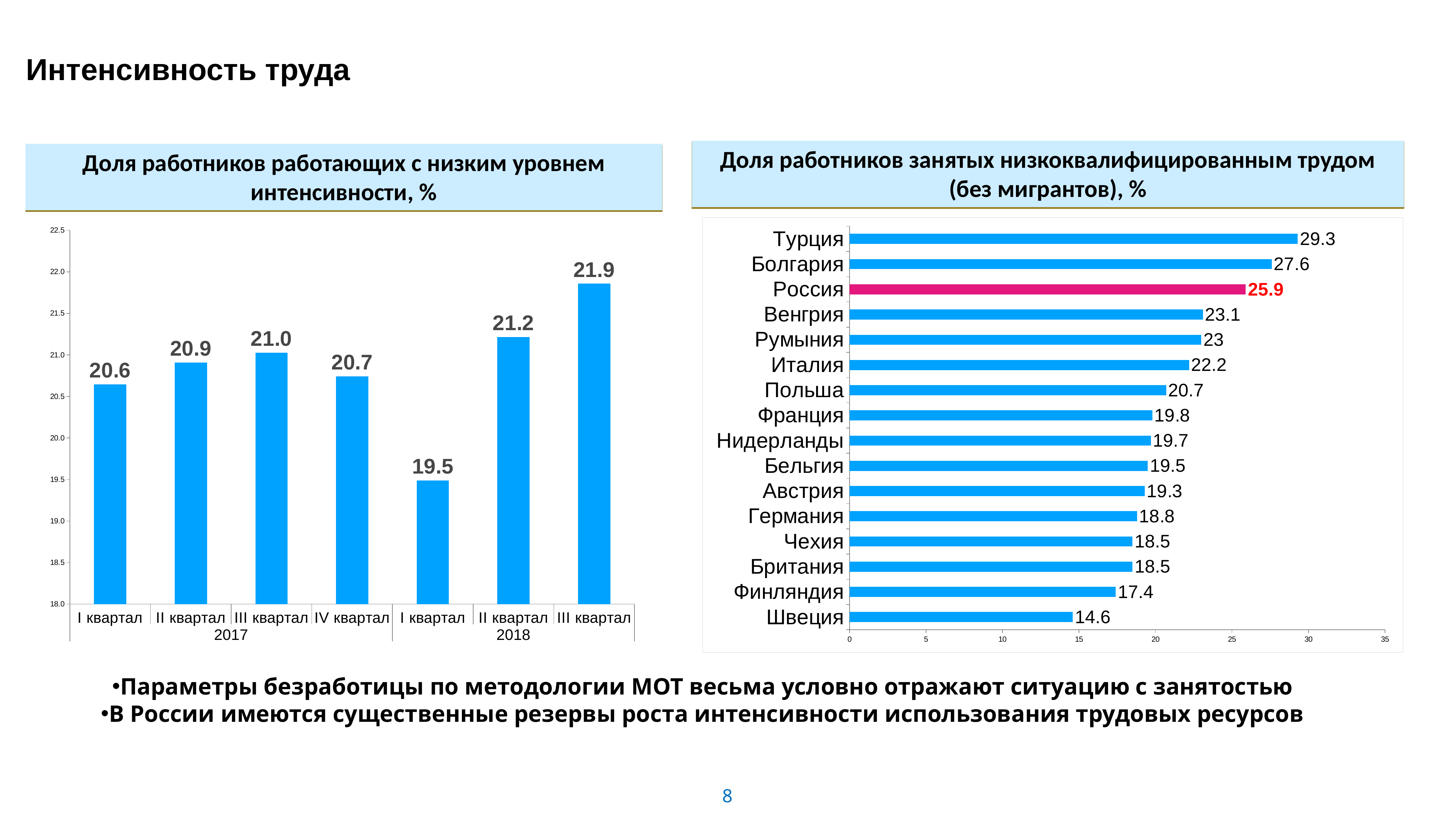
In the right chart (Доля работников занятых низкоквалифицированным трудом), how many countries are listed? 16 In the left chart (Доля работников работающих с низким уровнем интенсивности, %), which quarter has the lowest value? I квартал 2018 In the left chart (Доля работников работающих с низким уровнем интенсивности, %), which is larger: II квартал 2017 or IV квартал 2017? II квартал 2017 In the right chart (Доля работников занятых низкоквалифицированным трудом), what is the difference between Турция and Россия? 3.4 In the left chart (Доля работников работающих с низким уровнем интенсивности, %), what is the value for I квартал 2018? 19.5 In the right chart (Доля работников занятых низкоквалифицированным трудом), what is the value for Россия? 25.9 In the right chart (Доля работников занятых низкоквалифицированным трудом), which bar is highlighted in a different colour (pink/red) from the others? Россия In the right chart (Доля работников занятых низкоквалифицированным трудом), which country has the highest value? Турция In the right chart (Доля работников занятых низкоквалифицированным трудом), which country has the lowest value? Швеция In the left chart (Доля работников работающих с низким уровнем интенсивности, %), how many quarters are plotted? 7 In the left chart (Доля работников работающих с низким уровнем интенсивности, %), what is the value for III квартал 2018? 21.9 In the left chart (Доля работников работающих с низким уровнем интенсивности, %), what is the difference between III квартал 2018 and I квартал 2018? 2.4